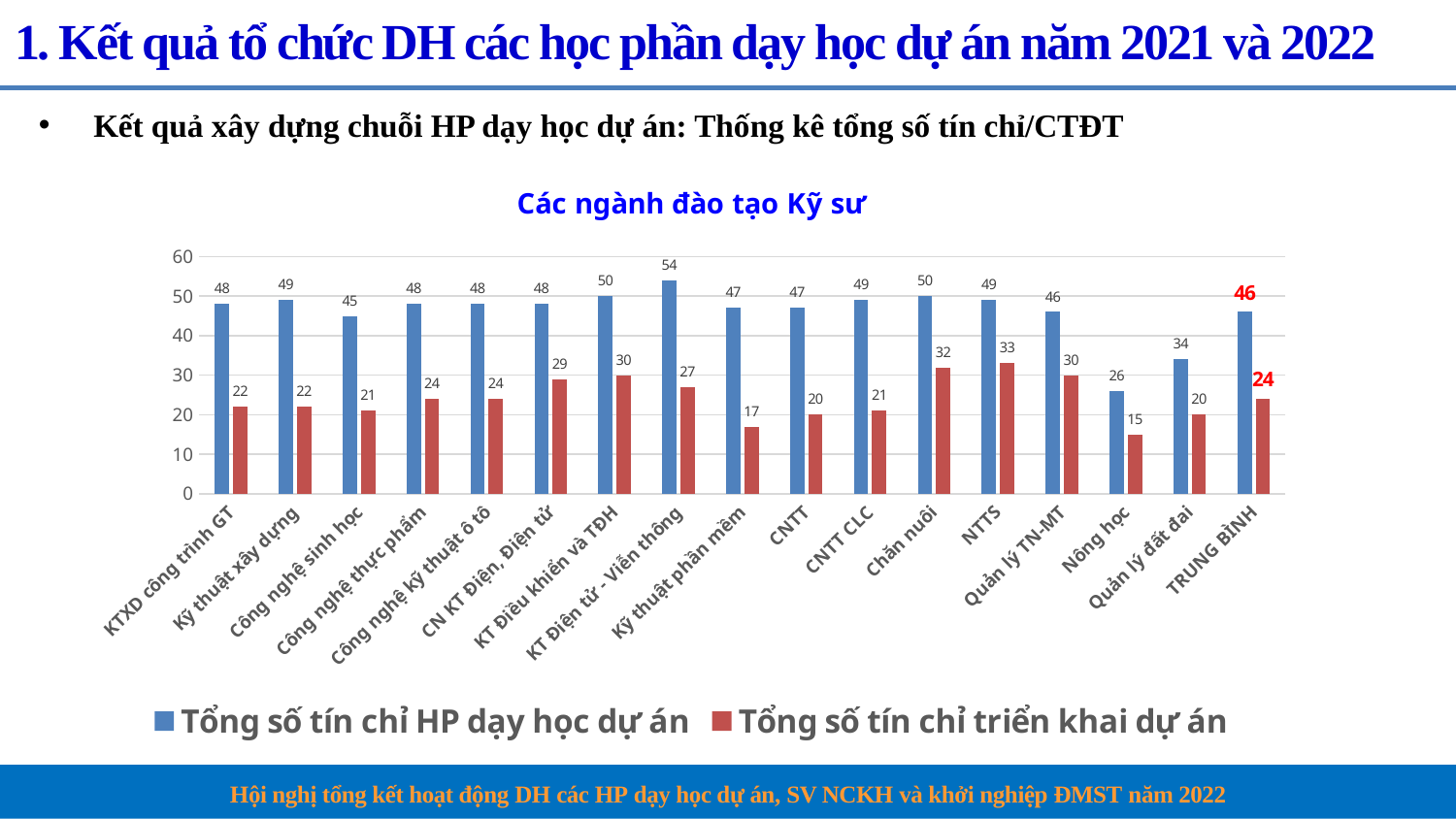
How many categories are shown on the x axis? 17 Which category has the highest value for 'Tổng số tín chỉ HP dạy học dự án'? KT Điện tử - Viễn thông Is the value of 'Tổng số tín chỉ HP dạy học dự án' for Nông học greater or less than 30? less What is the value of 'Tổng số tín chỉ HP dạy học dự án' for Quản lý đất đai? 34 What is the value of 'Tổng số tín chỉ HP dạy học dự án' for KT Điện tử - Viễn thông? 54 What type of chart is shown on the slide? bar chart Which is larger: 'Tổng số tín chỉ triển khai dự án' for Chăn nuôi or for Kỹ thuật phần mềm? Chăn nuôi What is the title of the chart? Các ngành đào tạo Kỹ sư What is the value of 'Tổng số tín chỉ triển khai dự án' for NTTS? 33 How many series does the legend list? 2 Which category has the lowest value for 'Tổng số tín chỉ triển khai dự án'? Nông học What is the difference between the two series for TRUNG BÌNH? 22